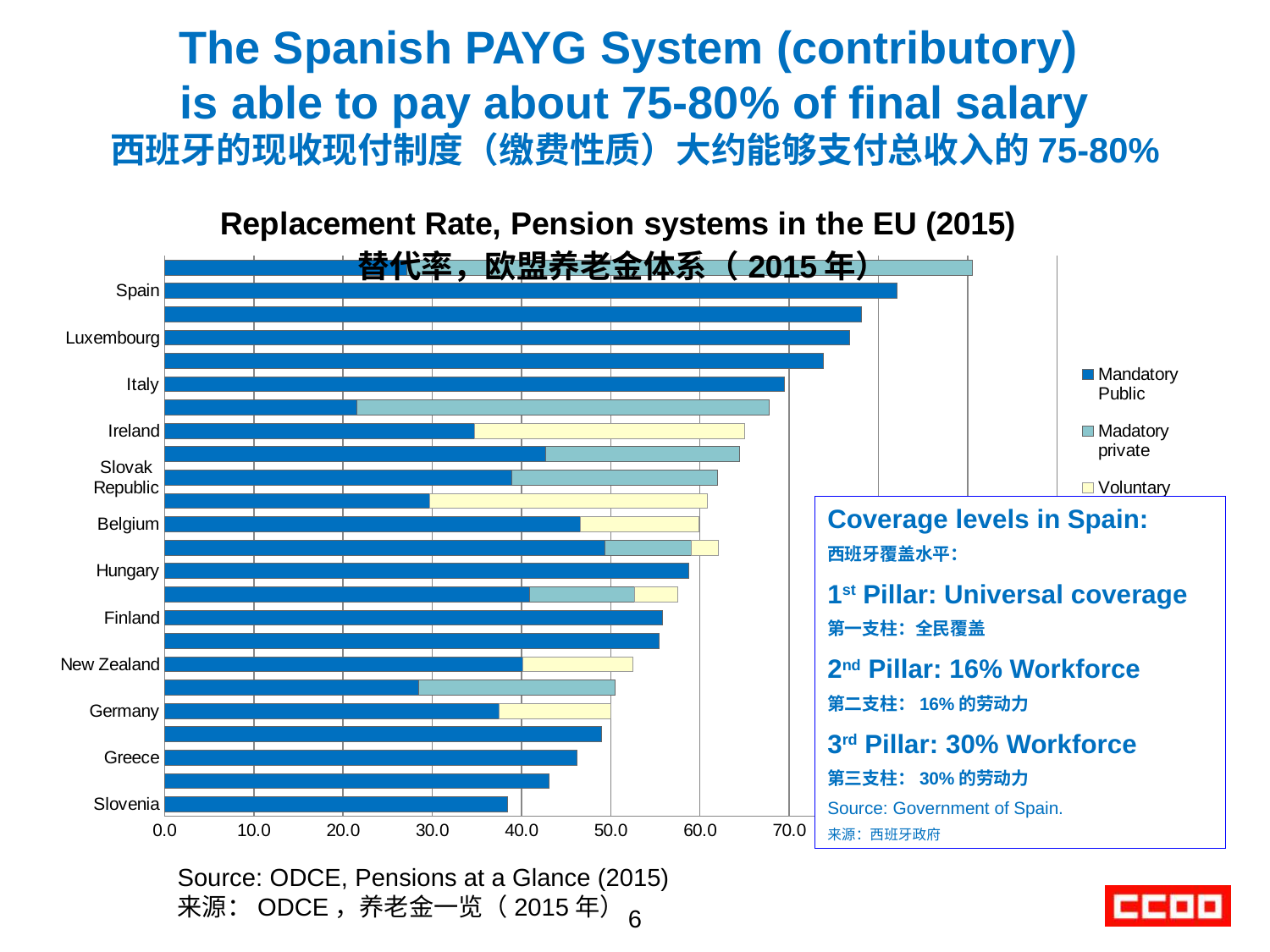
How many series does the chart legend list? 3 What is the English title of the chart? Replacement Rate, Pension systems in the EU (2015) What are the three series named in the chart legend? Mandatory Public, Madatory private, Voluntary Is the total replacement rate for Finland greater or less than 60.0? less Is the Mandatory Public value for Ireland greater or less than 40.0? less Is the total replacement rate for Greece greater or less than 50.0? less What kind of chart is shown on the slide? bar chart Which labeled country has the lowest total replacement rate in the chart? Slovenia Which has the larger total replacement rate, Spain or Slovenia? Spain